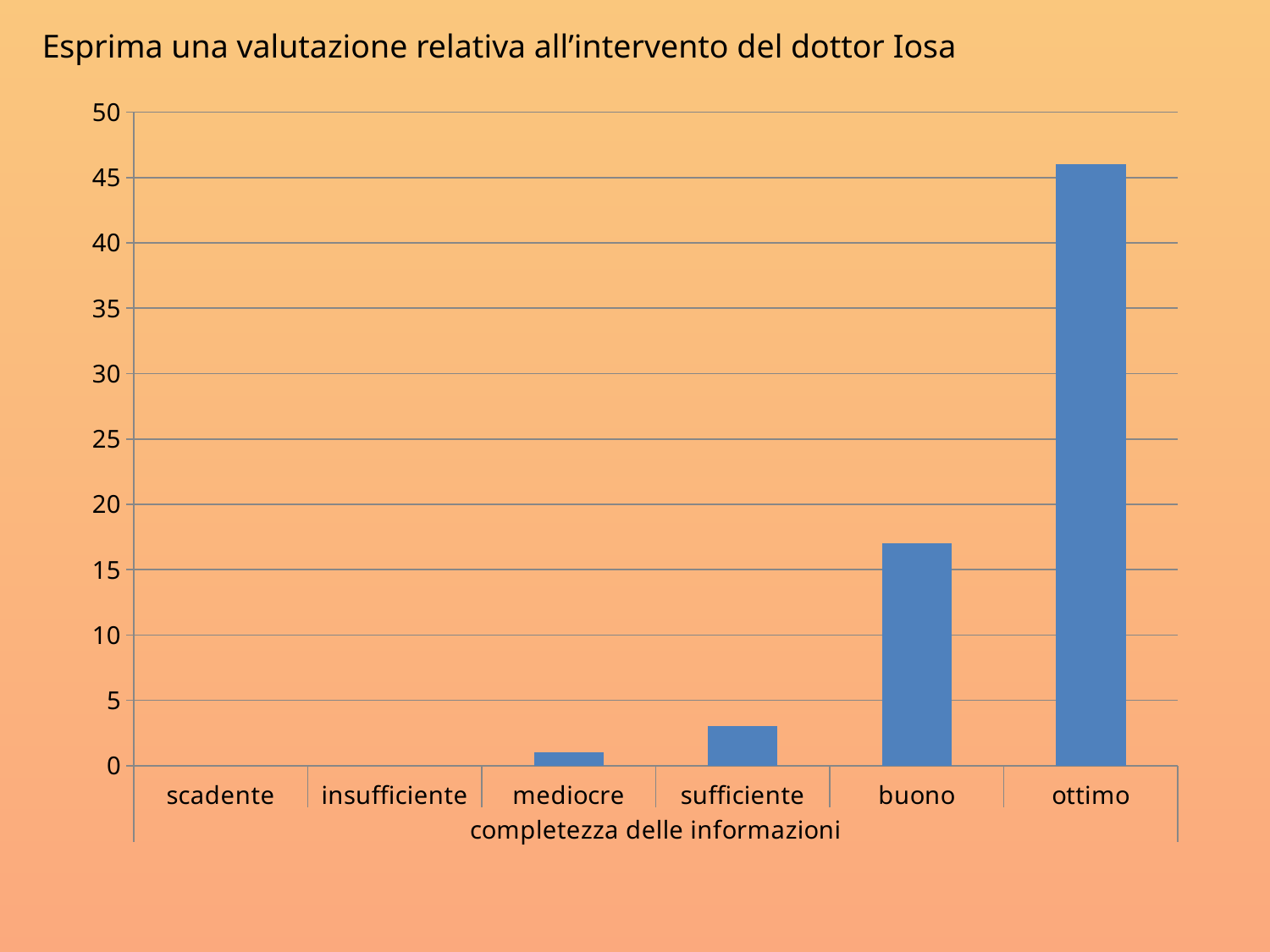
What is the title of the x axis? completezza delle informazioni What kind of chart is shown on the slide? bar chart Which category has the highest value? ottimo Is the value for buono greater or less than 20? less Is the value for buono greater or less than 15? greater Which is larger, the value for buono or the value for ottimo? ottimo How many categories are shown on the x axis? 6 Is the value for mediocre greater or less than 5? less Do the values rise or fall moving from scadente to ottimo along the x axis? rise Which is larger, the value for sufficiente or the value for mediocre? sufficiente